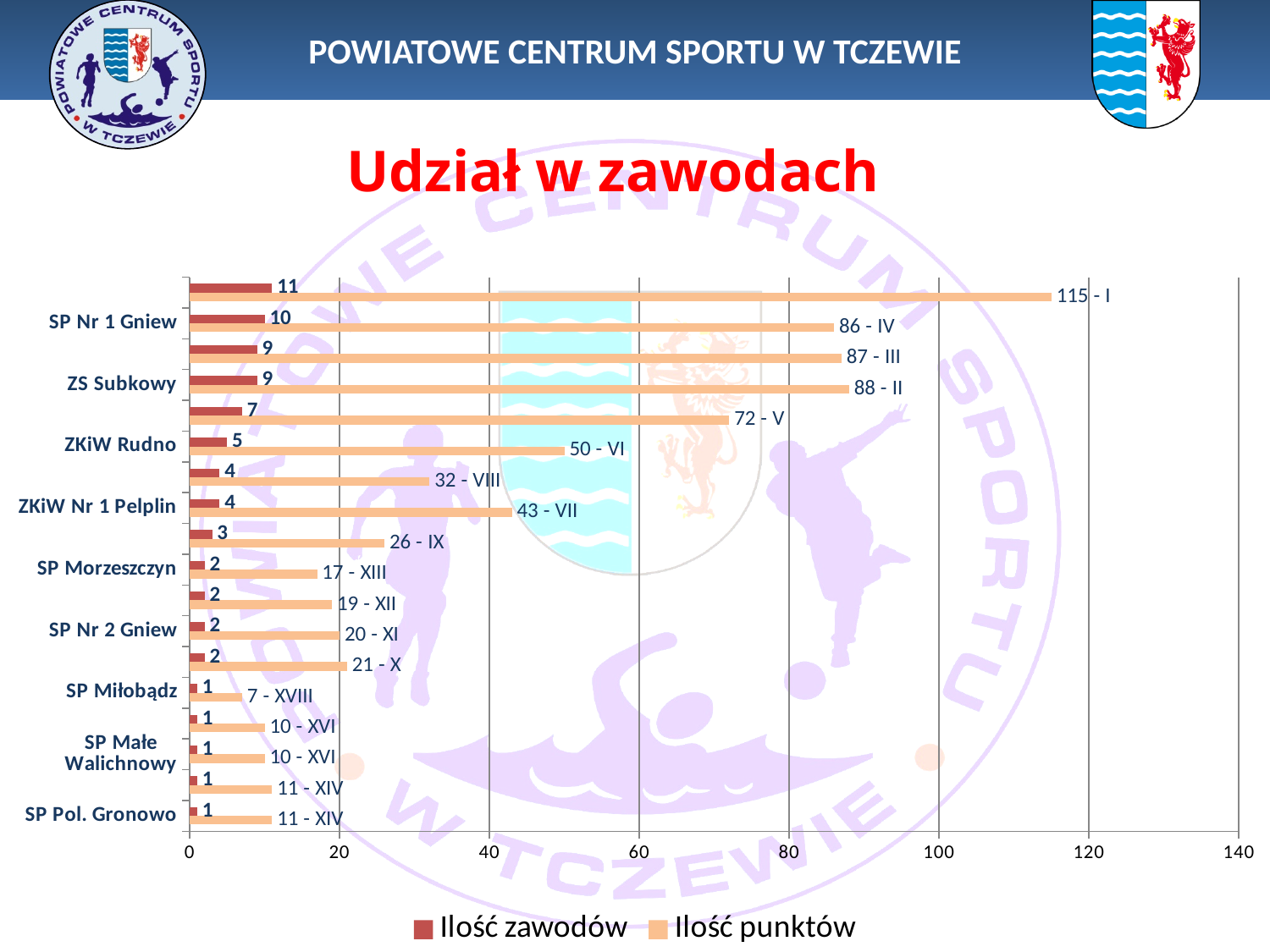
What is the Ilość punktów value for SP Nr 1 Gniew? 86 What is the title of the chart? Udział w zawodach What is the difference in Ilość punktów between ZS Subkowy (88) and SP Nr 1 Gniew (86)? 2 What are the two series named in the legend? Ilość zawodów and Ilość punktów What is the Ilość punktów value for SP Miłobądz? 7 Which has more Ilość punktów, ZKiW Rudno or ZKiW Nr 1 Pelplin? ZKiW Rudno What kind of chart is shown on the slide? Bar chart What is the Ilość zawodów value for ZS Subkowy? 9 Is the Ilość punktów value for SP Nr 1 Gniew greater or less than 80? greater What is the highest value of Ilość zawodów shown on the chart? 11 What is the highest value of Ilość punktów shown on the chart? 115 How many series does the legend list? 2